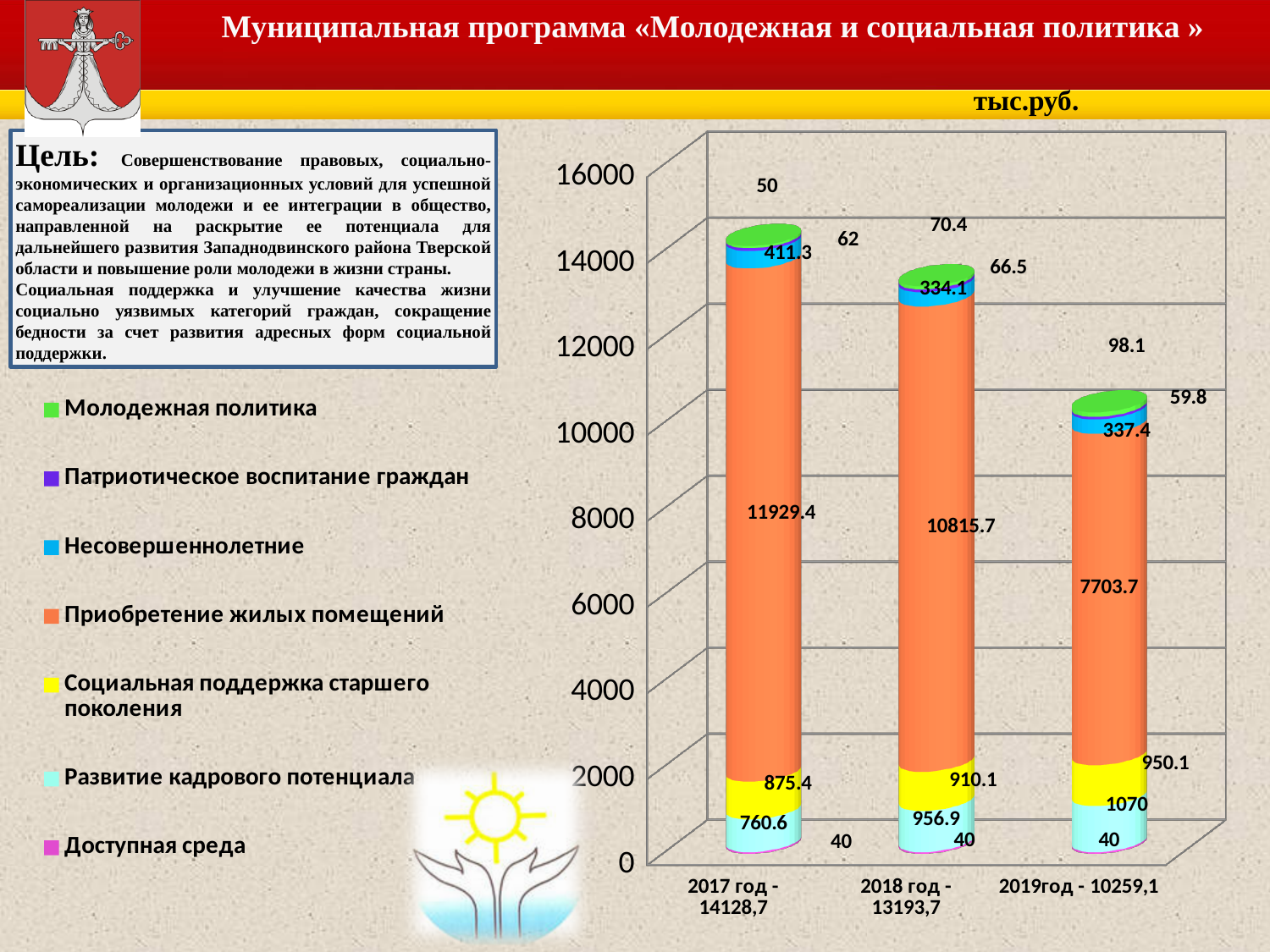
Do the values for Приобретение жилых помещений rise or fall from 2017 to 2019? fall How many year categories are shown on the x axis? 3 What is the value for Несовершеннолетние in 2017? 411.3 Which year has the lowest total? 2019 What is the value for Развитие кадрового потенциала in 2019? 1070 What is the value for Социальная поддержка старшего поколения in 2018? 910.1 What is the value for Приобретение жилых помещений in 2019? 7703.7 What is the value for Приобретение жилых помещений in 2017? 11929.4 What is the total of the stacked bar for 2018? 13193,7 What is the difference between the Приобретение жилых помещений values for 2017 and 2018? 1113.7 What type of chart is shown on the slide? stacked bar chart How many series does the legend list? 7